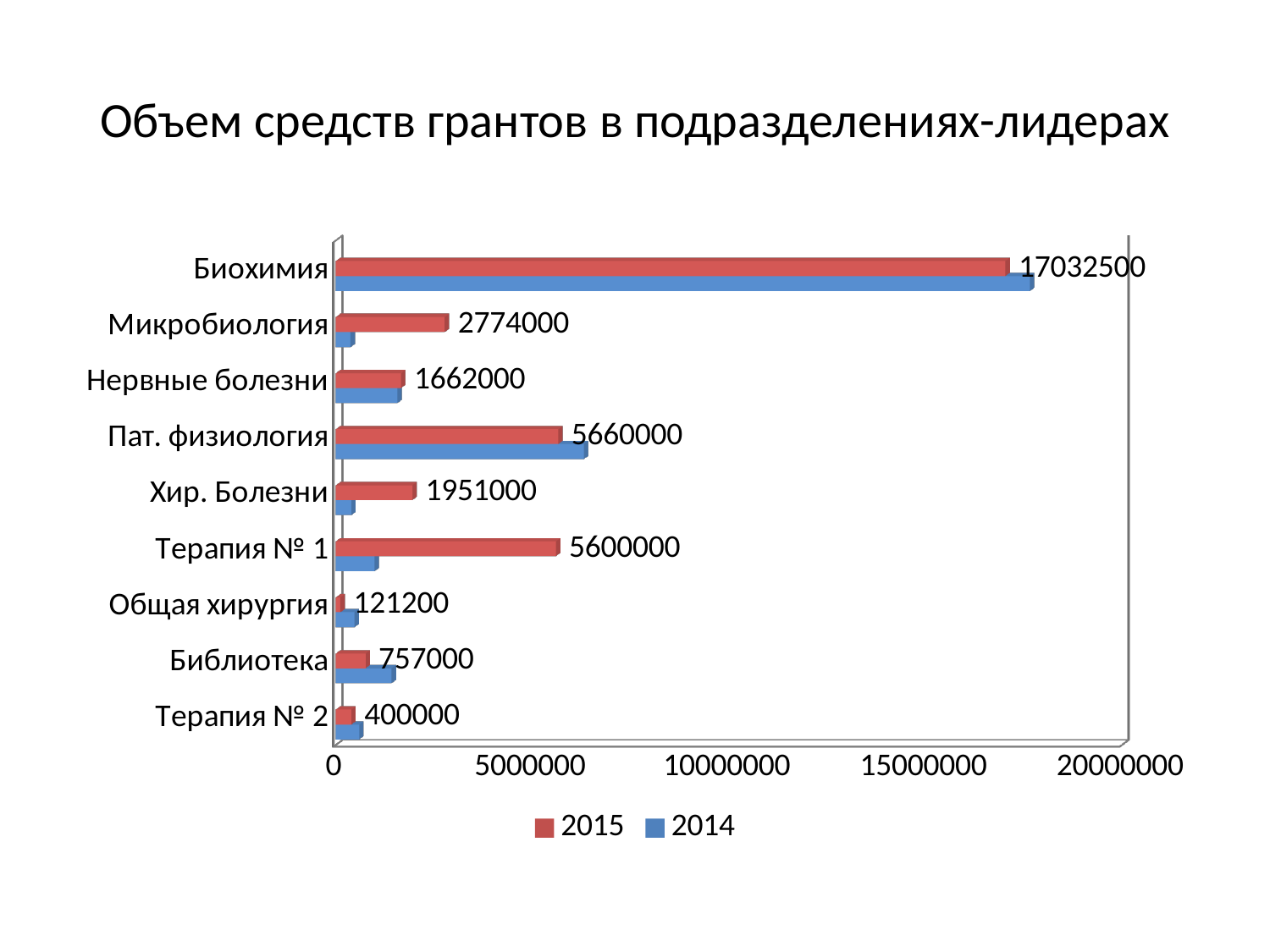
What is the 2015 value for Биохимия? 17032500 What is the 2015 value for Микробиология? 2774000 What kind of chart is shown on the slide? Bar chart What is the 2015 value for Библиотека? 757000 What is the difference between the 2015 values for Пат. физиология and Терапия № 1? 60000 How many series does the legend list? 2 Is the 2014 value for Микробиология greater or less than 5000000? less Which has the larger 2015 value, Хир. Болезни or Нервные болезни? Хир. Болезни Which category has the highest 2015 value? Биохимия How many categories are shown on the chart? 9 Which category has the lowest 2015 value? Общая хирургия Is the 2014 value for Биохимия greater or less than 15000000? greater